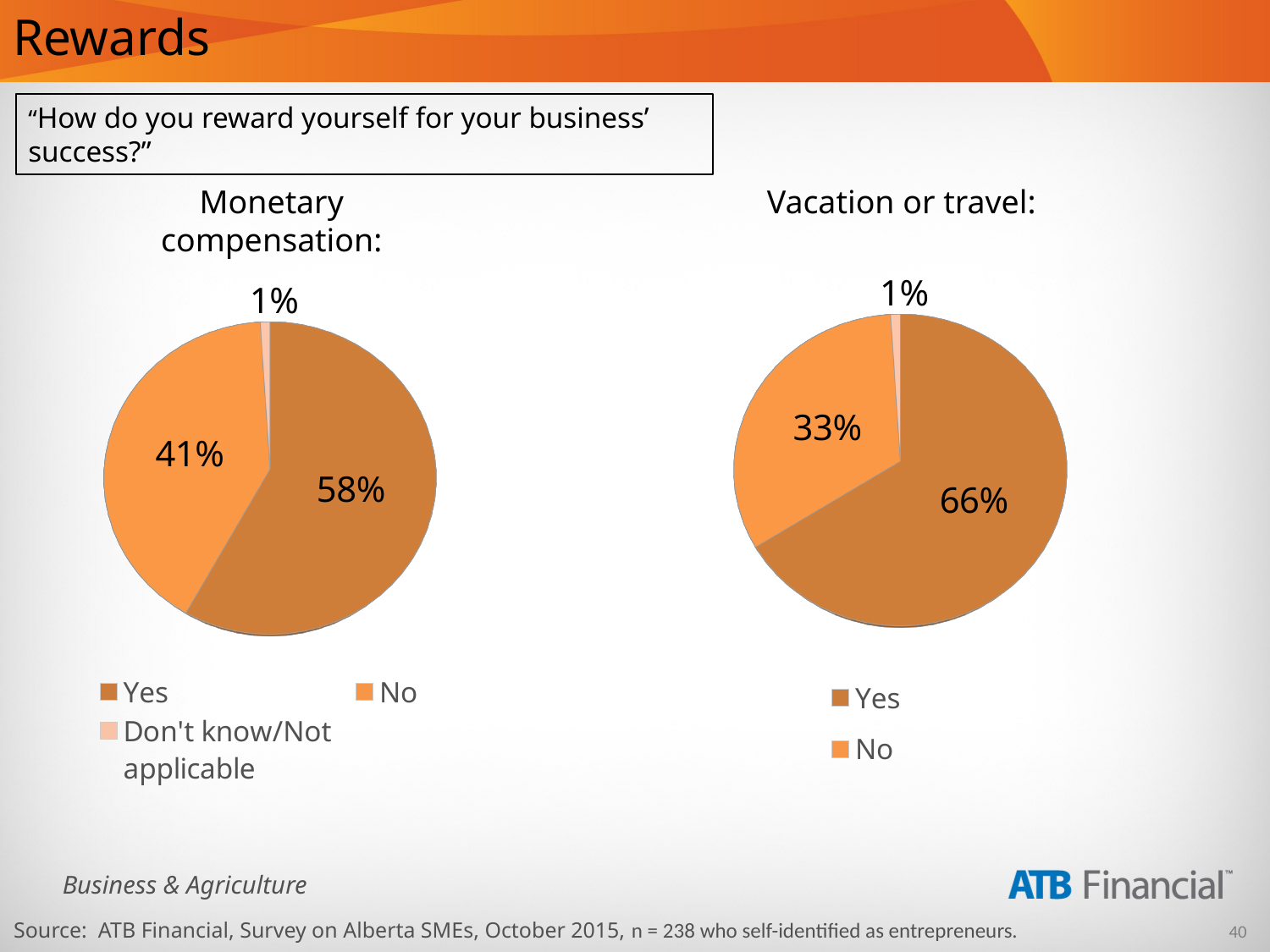
How many entries does the legend of the Monetary compensation chart list? 3 In the Monetary compensation chart, what percentage answered No? 41% In the Vacation or travel chart, which of the legend entries has the smallest slice? No In the Monetary compensation chart, what share of the pie is Don't know/Not applicable? 1% What type of chart is used for Vacation or travel? Pie chart In the Vacation or travel chart, what is the difference between the Yes and No percentages? 33% In the Vacation or travel chart, what percentage answered No? 33% In the Monetary compensation chart, what percentage answered Yes? 58% In the Monetary compensation chart, what is the difference between the Yes and No percentages? 17% Which chart has the larger Yes percentage, Monetary compensation or Vacation or travel? Vacation or travel In the Vacation or travel chart, what percentage answered Yes? 66% In the Monetary compensation chart, which response has the largest slice? Yes